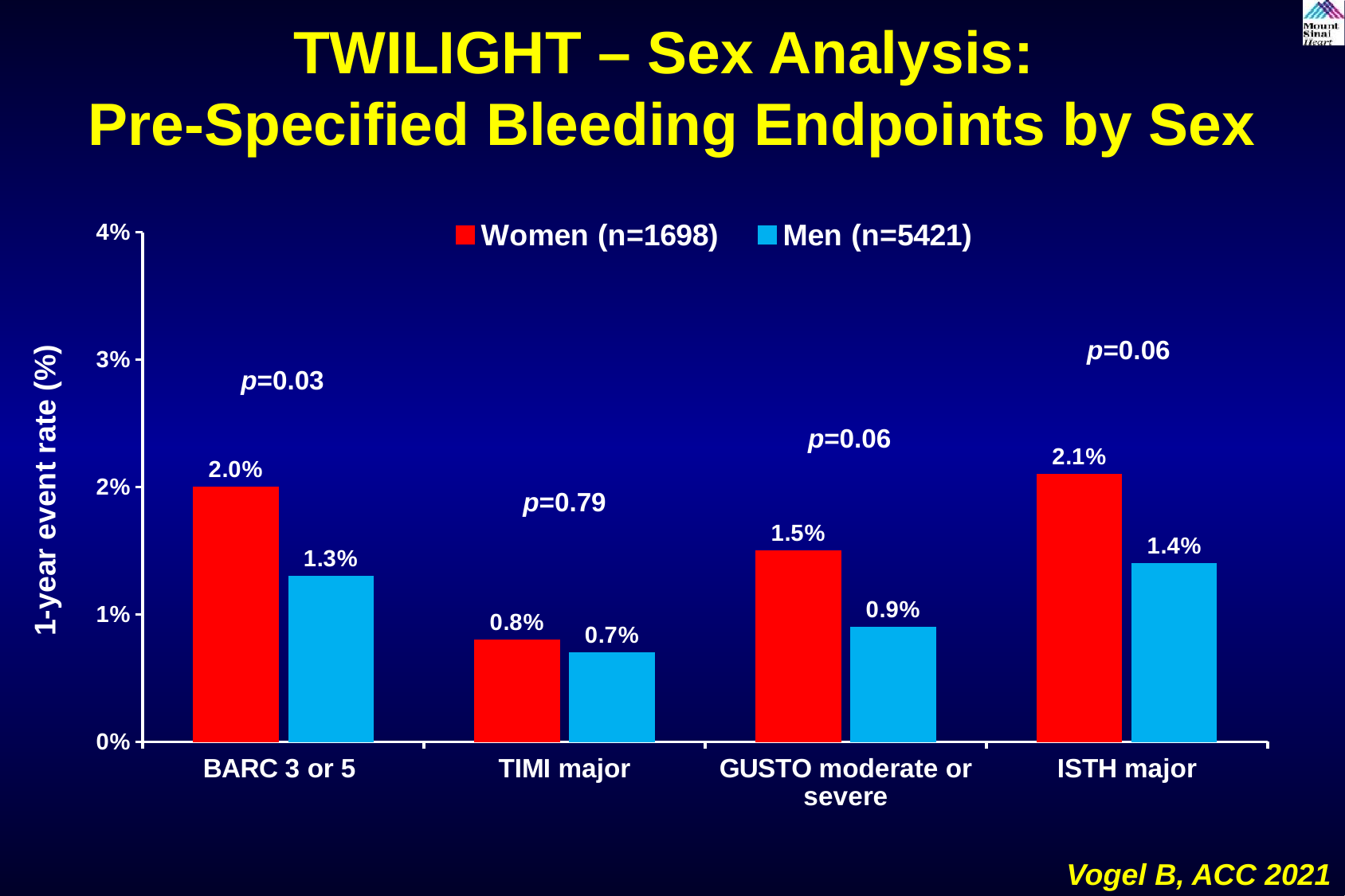
Is the Women event rate for ISTH major greater or less than 2%? greater How many bleeding endpoint categories are shown on the x axis? 4 What is the 1-year event rate for Men for ISTH major? 1.4% What kind of chart is shown on the slide? Bar chart What is the 1-year event rate for Men for GUSTO moderate or severe? 0.9% Which bleeding endpoint has the highest event rate for Women? ISTH major What p-value is shown for the TIMI major comparison? p=0.79 What is the difference between the Women and Men event rates for BARC 3 or 5? 0.7% Which is larger for GUSTO moderate or severe, the Women rate or the Men rate? Women How many series does the legend list? 2 What is the 1-year event rate for Women for BARC 3 or 5? 2.0% Which bleeding endpoint has the lowest event rate for Men? TIMI major